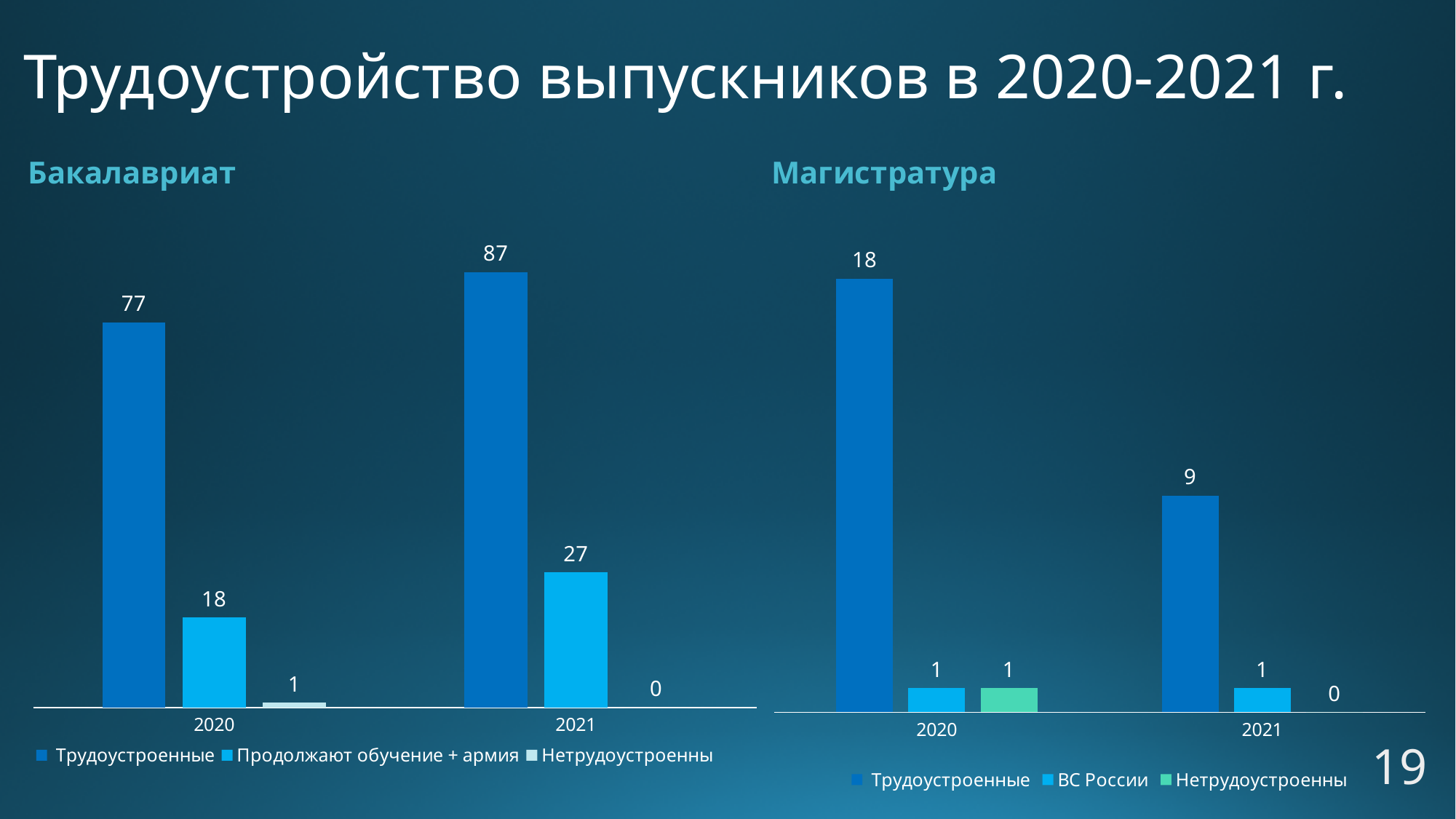
In the "Бакалавриат" chart, what is the difference between the "Трудоустроенные" values for 2021 and 2020? 10 In the "Бакалавриат" chart, does the value for "Трудоустроенные" rise or fall from 2020 to 2021? Rise In the "Магистратура" chart, what is the difference between the "Трудоустроенные" values for 2020 and 2021? 9 In the "Бакалавриат" chart, which year has the higher value for "Продолжают обучение + армия"? 2021 In the "Магистратура" chart, which year has the lower value for "Трудоустроенные"? 2021 What type of chart is the "Бакалавриат" chart? Bar chart In the "Магистратура" chart, what is the value for "Трудоустроенные" in 2021? 9 In the "Бакалавриат" chart, what is the value for "Трудоустроенные" in 2020? 77 In the "Магистратура" chart, what is the value for "ВС России" in 2020? 1 In the "Бакалавриат" chart, which series has the highest value in 2021? Трудоустроенные How many series does the legend of the "Магистратура" chart list? 3 In the "Бакалавриат" chart, what is the value for "Продолжают обучение + армия" in 2021? 27